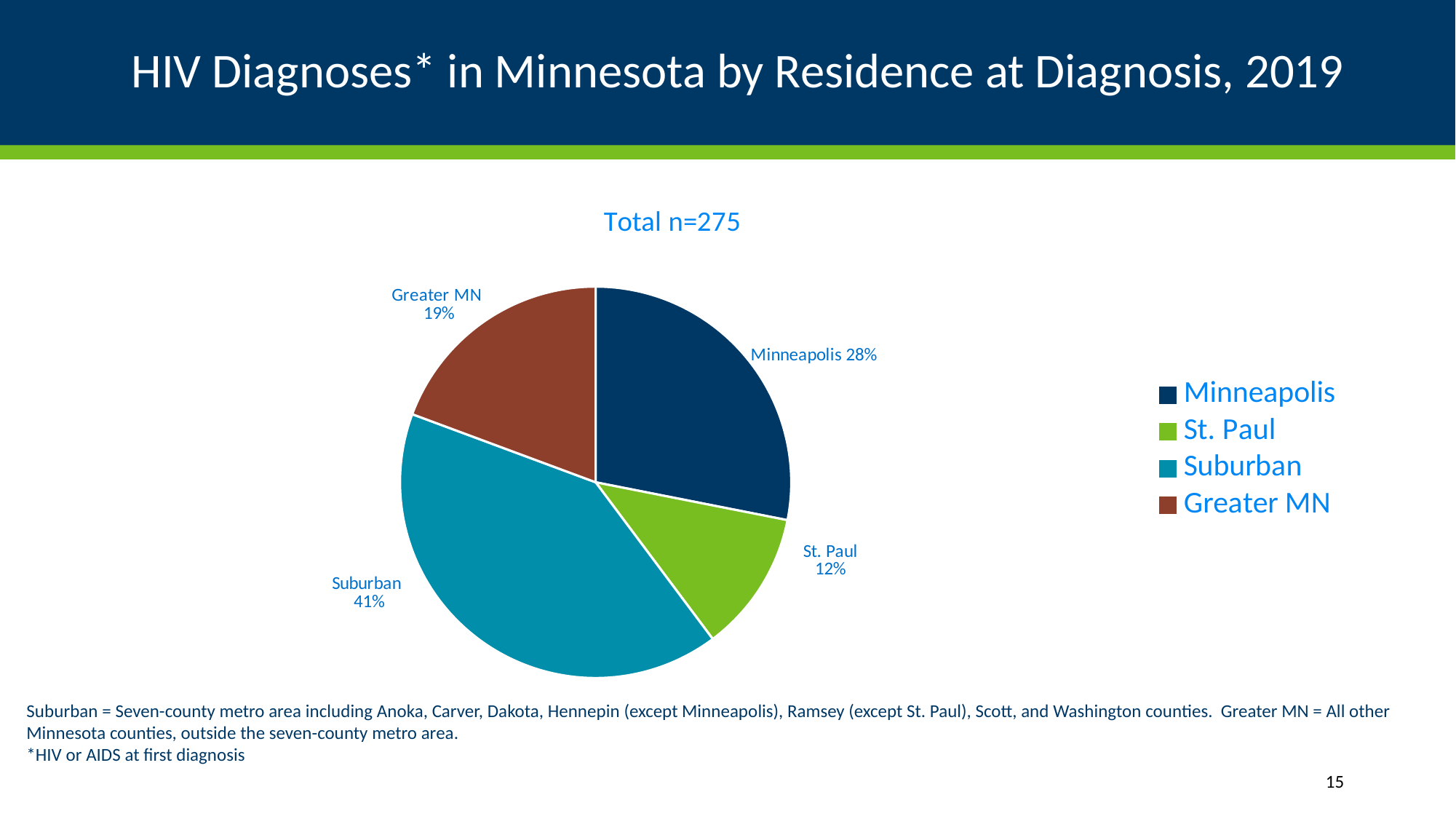
How many residence categories are shown in the pie chart? 4 What share of HIV diagnoses is shown for St. Paul? 12% What kind of chart is shown on the slide? Pie chart What is the total number of HIV diagnoses (n) shown above the chart? 275 What colour is the Suburban slice in the pie chart? Teal Which residence category has the largest share of HIV diagnoses? Suburban What share of HIV diagnoses is shown for Minneapolis? 28% What share of HIV diagnoses is shown for Suburban? 41% What is the difference in percentage points between the Suburban and Minneapolis shares? 13 Which has a larger share of HIV diagnoses, Greater MN or St. Paul? Greater MN What share of HIV diagnoses is shown for Greater MN? 19% Which residence category has the smallest share of HIV diagnoses? St. Paul